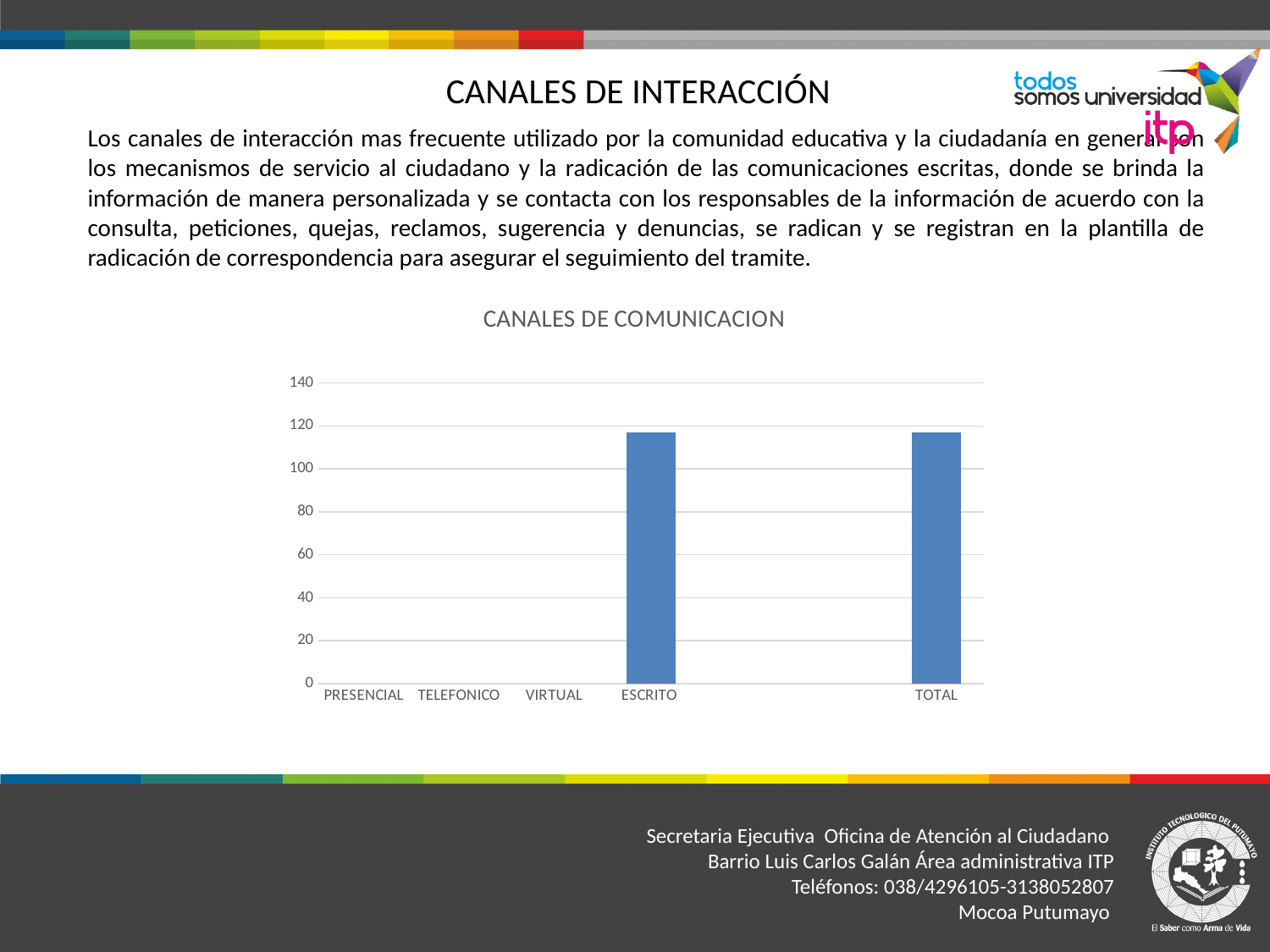
Is the value for TOTAL greater or less than 100? greater Is the value for ESCRITO greater or less than 120? less How many category labels are shown on the x axis of the chart? 5 Which category has a larger value, PRESENCIAL or ESCRITO? ESCRITO What kind of chart is shown under the title CANALES DE COMUNICACION? bar chart Is the value for ESCRITO greater or less than 100? greater What is the title of the chart on the slide? CANALES DE COMUNICACION What is the highest value shown on the y axis of the chart? 140 Which categories on the chart have no visible bar? PRESENCIAL, TELEFONICO, VIRTUAL How many bars are visible on the chart? 2